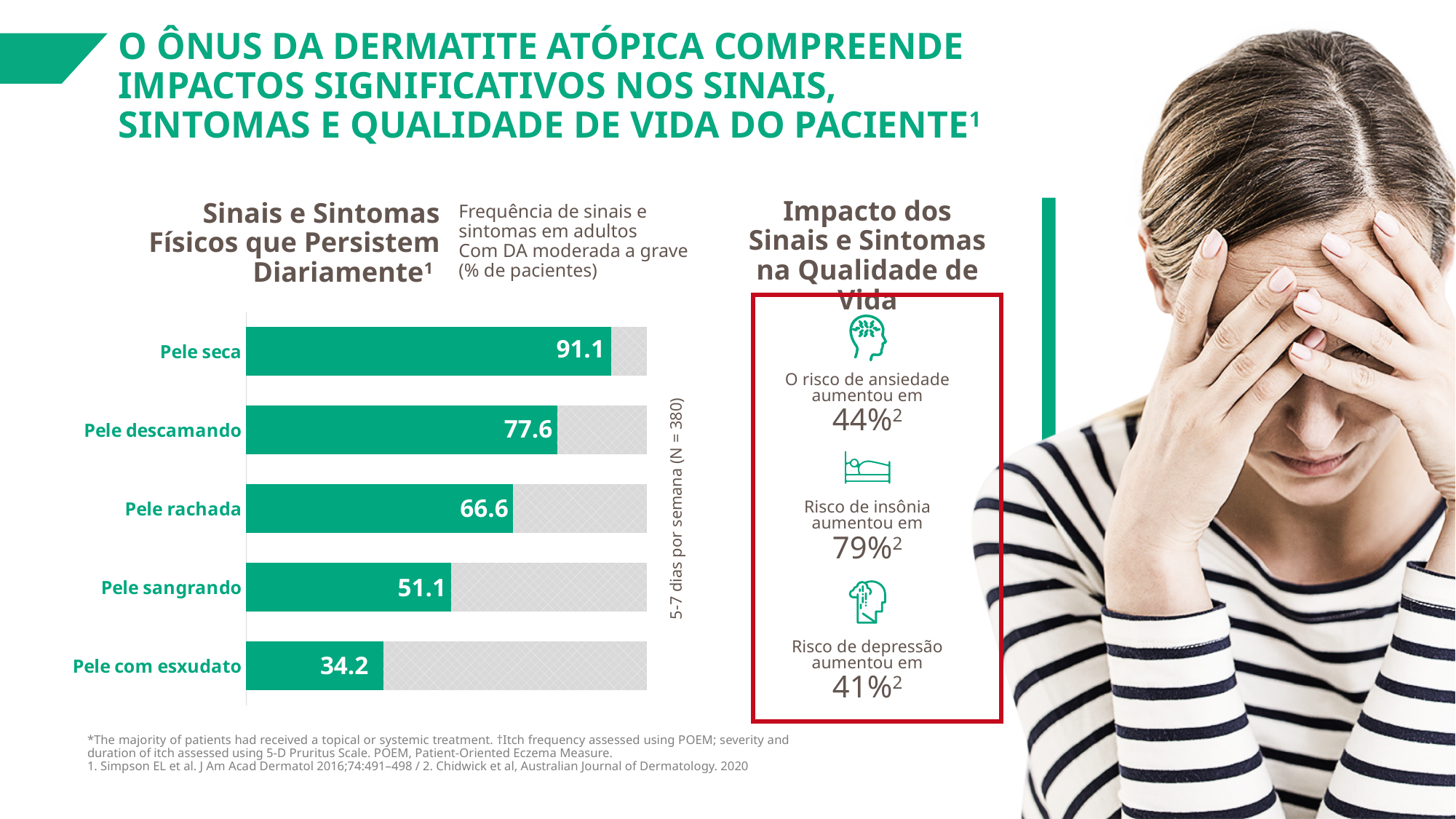
Which category has the lowest value? Pele com esxudato What is the value for Pele com esxudato? 34.2 What is the value for Pele descamando? 77.6 What kind of chart is shown on the slide? Bar chart What is the value for Pele sangrando? 51.1 Which is larger, the value for Pele rachada or the value for Pele sangrando? Pele rachada What is the value for Pele rachada? 66.6 Which category has the highest value? Pele seca How many categories are shown in the bar chart? 5 What is the difference between the values for Pele seca and Pele com esxudato? 56.9 What is the label on the vertical axis to the right of the bars? 5-7 dias por semana (N = 380) What is the value for Pele seca? 91.1